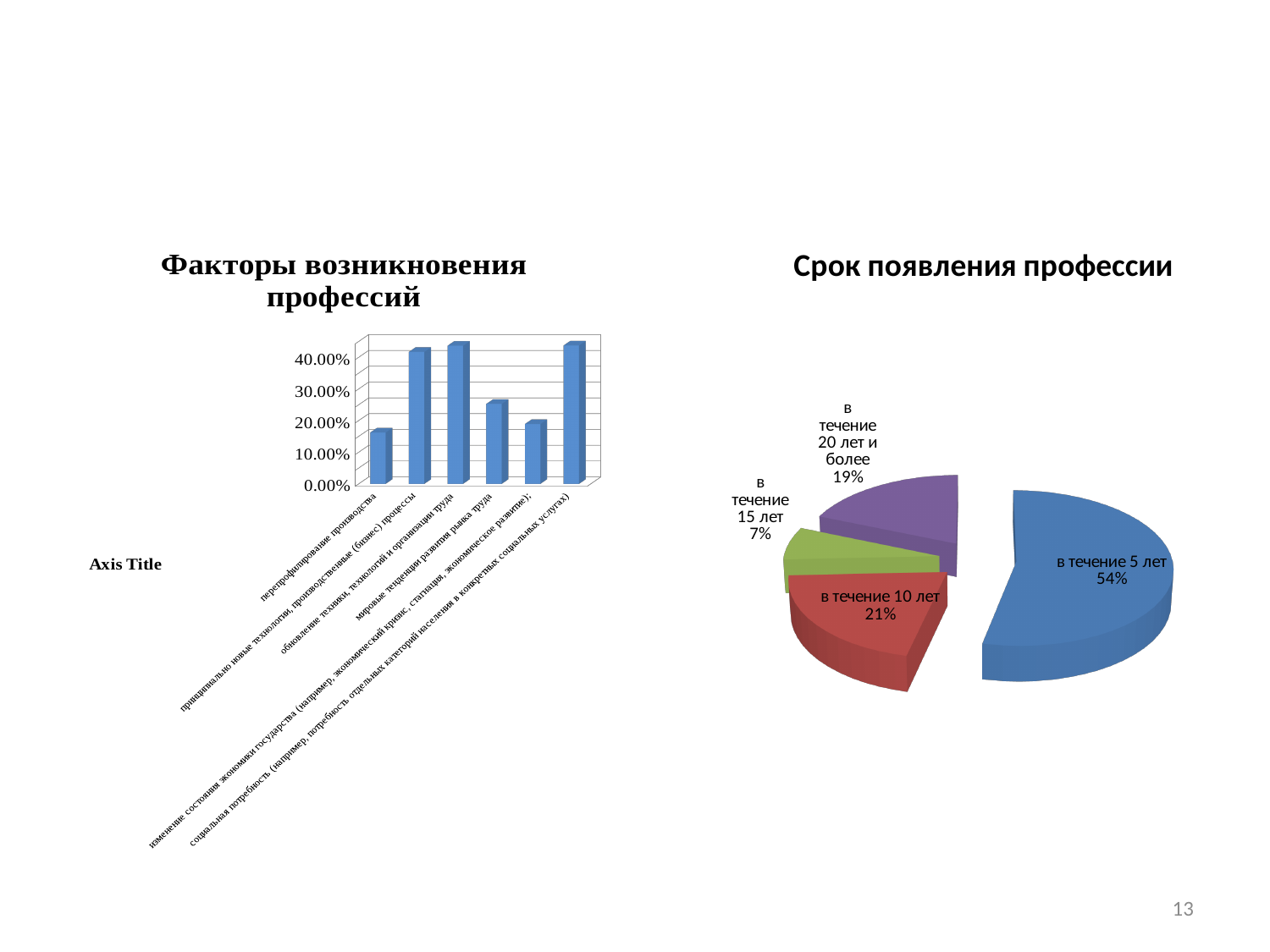
What kind of chart is the one titled "Срок появления профессии"? Pie chart On the chart titled "Срок появления профессии", what is the value for "в течение 15 лет"? 7% On the chart titled "Срок появления профессии", which category has the smallest share? в течение 15 лет On the chart titled "Срок появления профессии", which category has the largest share? в течение 5 лет On the chart titled "Срок появления профессии", what is the value for "в течение 10 лет"? 21% On the chart titled "Срок появления профессии", how many slices does the pie have? 4 On the chart titled "Срок появления профессии", what share of the pie is "в течение 5 лет"? 54% What kind of chart is the one titled "Факторы возникновения профессий"? Bar chart On the chart titled "Срок появления профессии", what is the difference between "в течение 5 лет" and "в течение 10 лет"? 33% On the chart titled "Факторы возникновения профессий", is the value for "мировые тенденции развития рынка труда" greater or less than 20.00%? greater On the chart titled "Факторы возникновения профессий", is the value for "перепрофилирование производства" greater or less than 20.00%? less On the chart titled "Факторы возникновения профессий", how many bars are plotted? 6